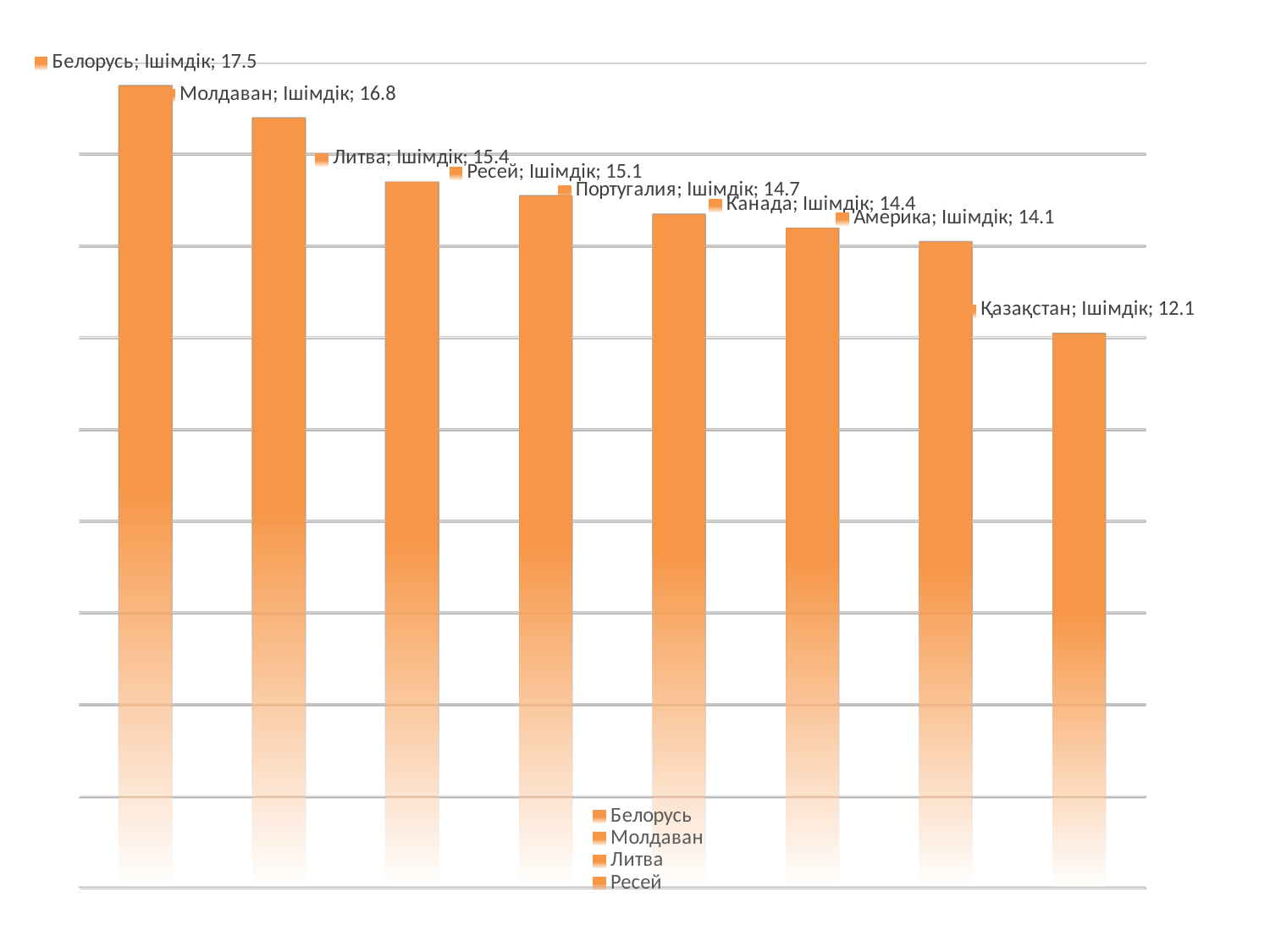
What is the value for Ресей? 15.1 What is the value for Белорусь? 17.5 Which is larger, the value for Канада or the value for Америка? Канада Do the values rise or fall from left to right across the bars? Fall What is the difference between the values for Молдаван and Литва? 1.4 What is the value for Қазақстан? 12.1 What is the difference between the values for Белорусь and Қазақстан? 5.4 What kind of chart is shown on the slide? Bar chart Which category has the highest value? Белорусь What is the value for Португалия? 14.7 Which category has the lowest value? Қазақстан How many bars are shown in the chart? 8